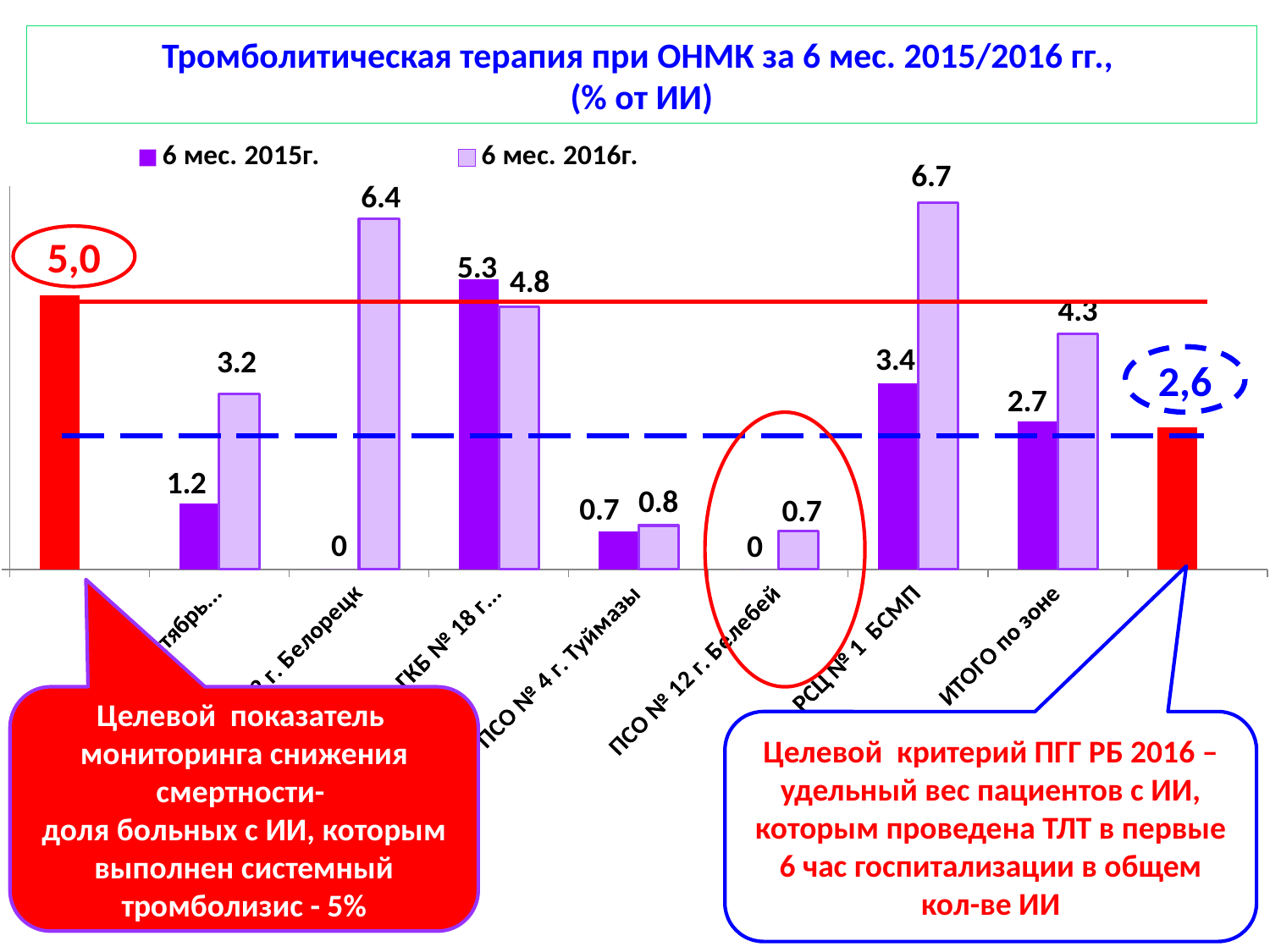
What value is shown in the red circle at the left of the chart, marking the solid red target line? 5,0 What is the value for г. Белорецк in the 6 мес. 2016г. series? 6.4 What is the value for РСЦ № 1 БСМП in the 6 мес. 2015г. series? 3.4 Which category has the highest value in the 6 мес. 2016г. series? РСЦ № 1 БСМП What is the value for ИТОГО по зоне in the 6 мес. 2016г. series? 4.3 What is the difference between the 6 мес. 2016г. and 6 мес. 2015г. values for ИТОГО по зоне? 1.6 What is the difference between the 6 мес. 2016г. and 6 мес. 2015г. values for РСЦ № 1 БСМП? 3.3 Which is larger for ГКБ № 18: the 6 мес. 2015г. value or the 6 мес. 2016г. value? 6 мес. 2015г. What kind of chart is shown on the slide? bar chart How many series does the chart legend list? 2 What is the value for ПСО № 12 г. Белебей in the 6 мес. 2015г. series? 0 Which is larger for ПСО № 4 г. Туймазы: the 6 мес. 2015г. value or the 6 мес. 2016г. value? 6 мес. 2016г.